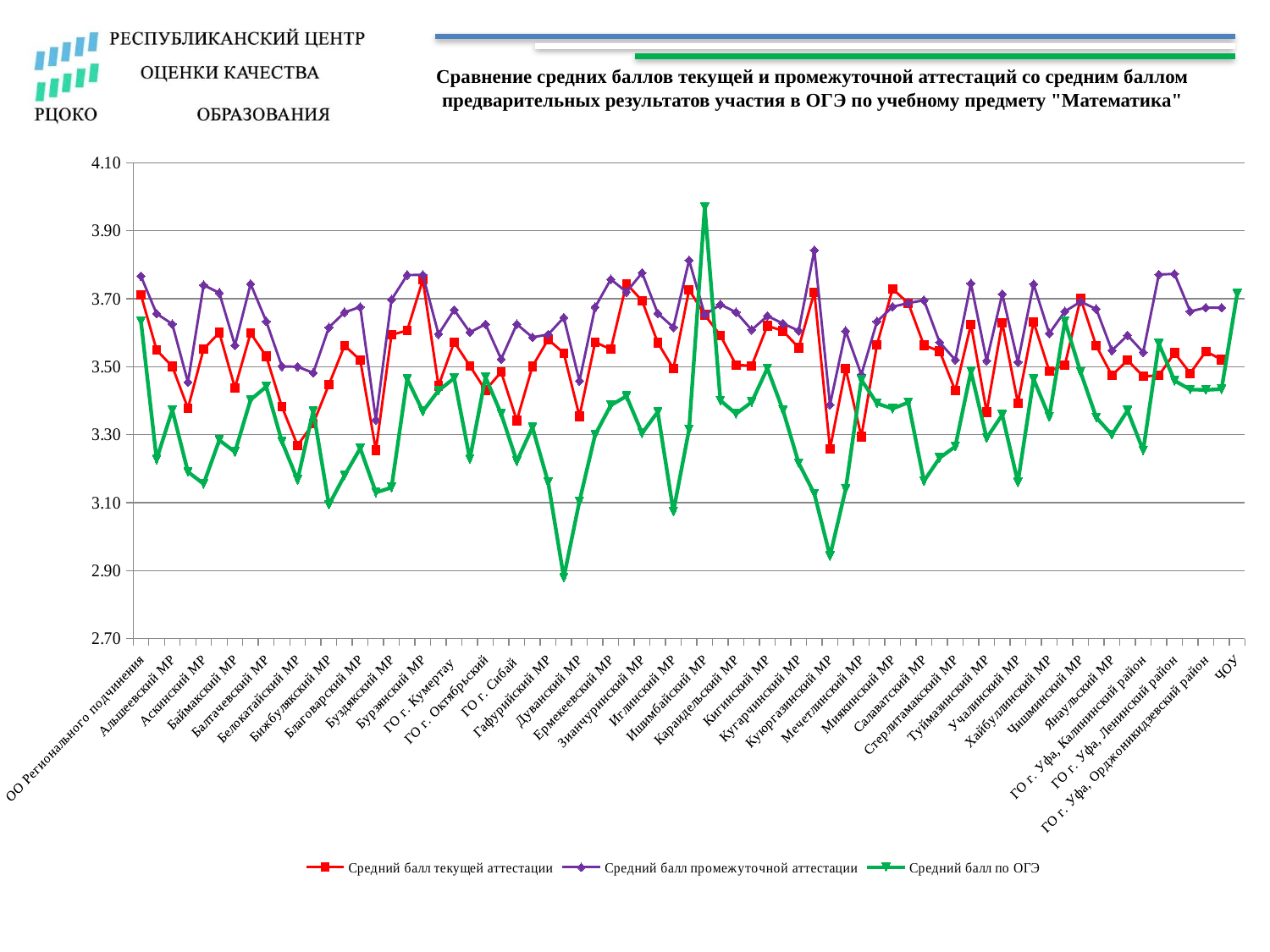
Is the value of Средний балл по ОГЭ for ЧОУ greater or less than 3.50? greater Is the value of Средний балл по ОГЭ for ОО Регионального подчинения greater or less than 3.30? greater Which series reaches the lowest point anywhere on the chart? Средний балл по ОГЭ What is the highest value shown on the vertical axis? 4.10 Is the value of Средний балл текущей аттестации for ОО Регионального подчинения greater or less than 3.50? greater How many series does the legend list? 3 What kind of chart is shown on the slide? Line chart Which series is drawn in green according to the legend? Средний балл по ОГЭ Which series reaches the highest point anywhere on the chart? Средний балл по ОГЭ For ОО Регионального подчинения, which is larger: Средний балл промежуточной аттестации or Средний балл по ОГЭ? Средний балл промежуточной аттестации